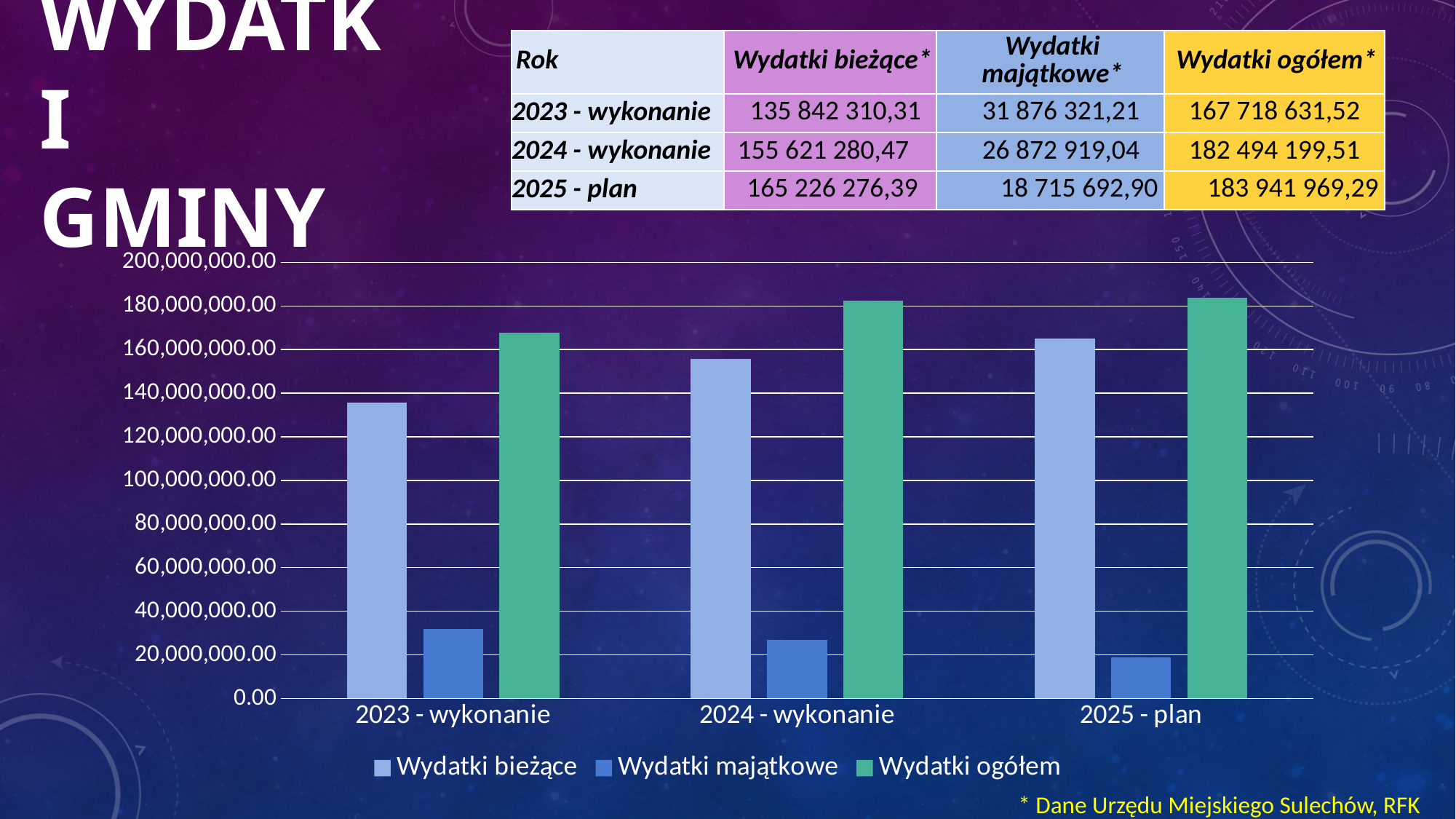
Is the value of Wydatki bieżące for 2023 - wykonanie greater or less than 140,000,000.00? less Which category has the lowest value for Wydatki majątkowe? 2025 - plan Do the values of Wydatki majątkowe rise or fall from 2023 - wykonanie to 2025 - plan? fall How many series does the chart legend list? 3 How many categories are shown on the x axis of the chart? 3 What kind of chart is shown on the slide? bar chart Is the value of Wydatki ogółem for 2024 - wykonanie greater or less than 180,000,000.00? greater What is the value of Wydatki bieżące for 2023 - wykonanie? 135 842 310,31 What is the value of Wydatki majątkowe for 2024 - wykonanie? 26 872 919,04 Which category has the highest value for Wydatki bieżące? 2025 - plan What is the difference between Wydatki bieżące for 2024 - wykonanie and for 2023 - wykonanie? 19 778 970,16 What is the value of Wydatki ogółem for 2025 - plan? 183 941 969,29